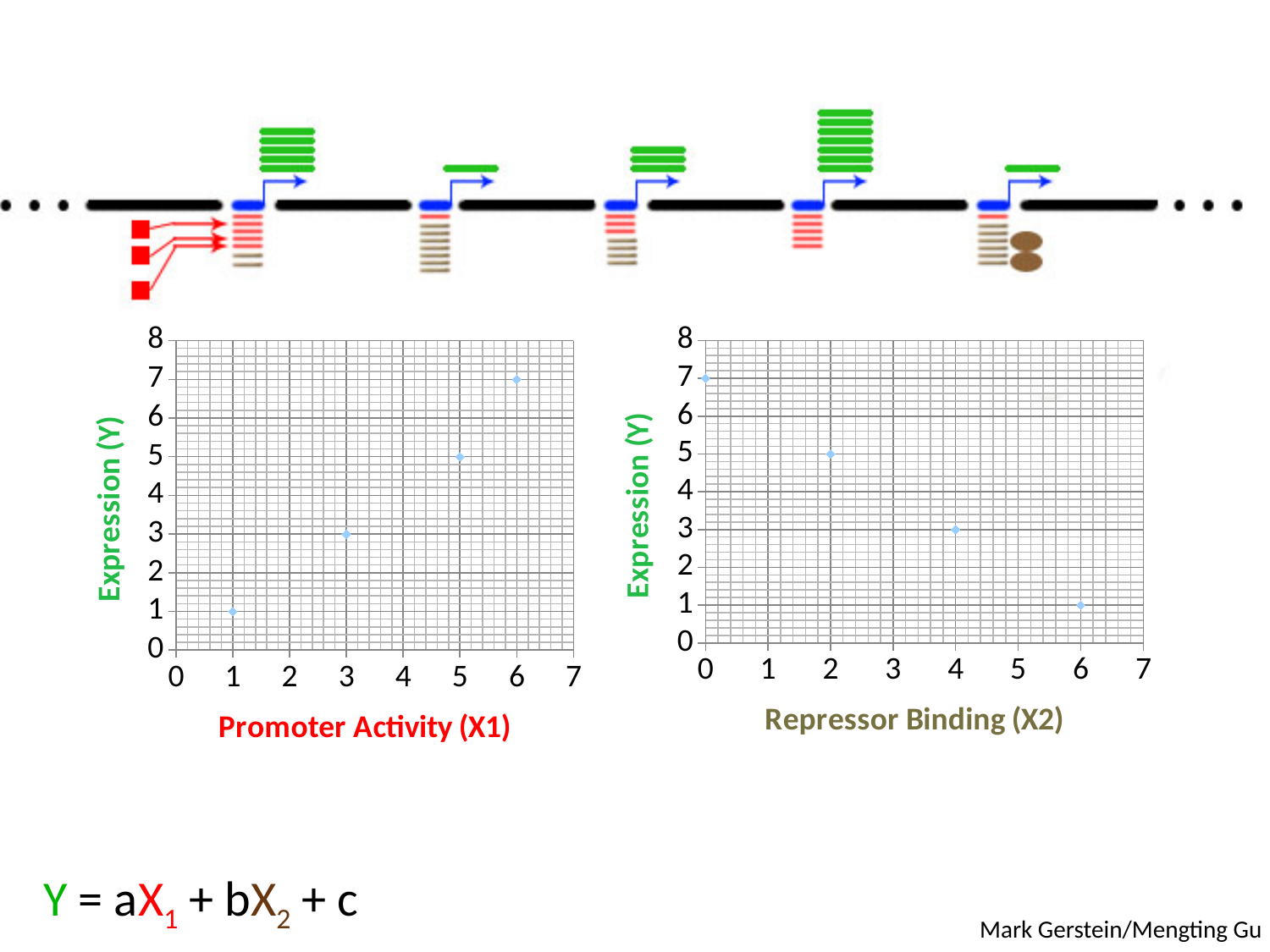
In the left chart, what is the Expression (Y) value when Promoter Activity (X1) is 6? 7 In the left chart, which Promoter Activity (X1) value has the lowest Expression (Y)? 1 In the right chart, what is the difference in Expression (Y) between Repressor Binding (X2) of 0 and of 6? 6 In the left chart (Promoter Activity), how many data points are plotted? 4 In the left chart, does Expression (Y) rise or fall as Promoter Activity (X1) increases? rise In the left chart, what is the Expression (Y) value when Promoter Activity (X1) is 3? 3 In the right chart, what is the Expression (Y) value when Repressor Binding (X2) is 4? 3 In the right chart, what is the Expression (Y) value when Repressor Binding (X2) is 0? 7 What kind of chart is the left chart, with x axis Promoter Activity (X1)? scatter chart What is the x-axis label of the right chart? Repressor Binding (X2) In the right chart (Repressor Binding), how many data points are plotted? 4 In the right chart, does Expression (Y) rise or fall as Repressor Binding (X2) increases? fall